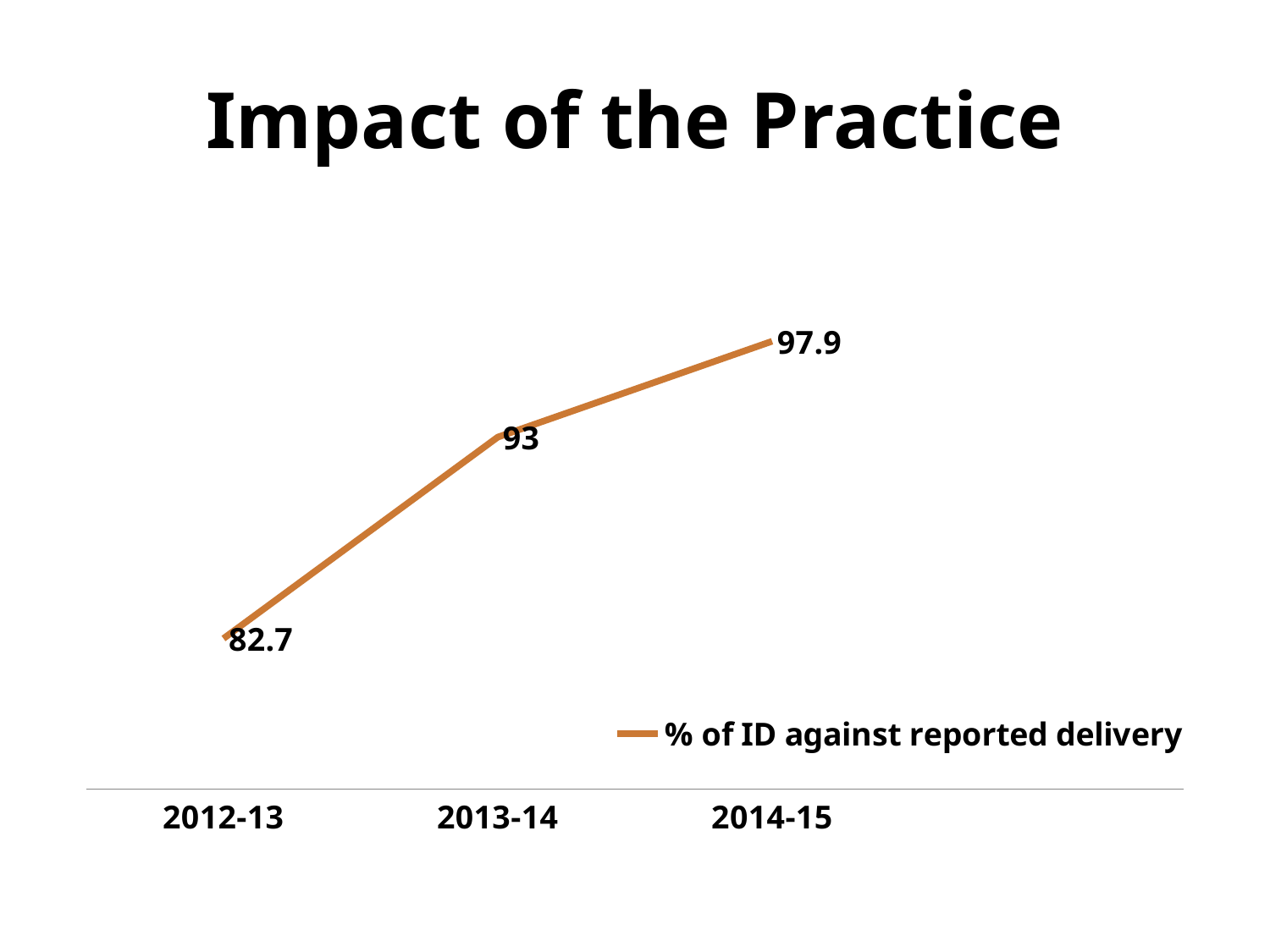
Which is larger, the value for 2013-14 or the value for 2014-15? 2014-15 What kind of chart is shown on the slide? line chart What is the value for 2014-15? 97.9 Which year has the lowest value? 2012-13 What is the difference between the values for 2014-15 and 2012-13? 15.2 What is the value for 2012-13? 82.7 What is the value for 2013-14? 93 Do the values rise or fall from 2012-13 to 2014-15? rise How many data points are plotted on the chart? 3 How many series does the legend list? 1 What is the difference between the values for 2013-14 and 2012-13? 10.3 Which year has the highest value? 2014-15